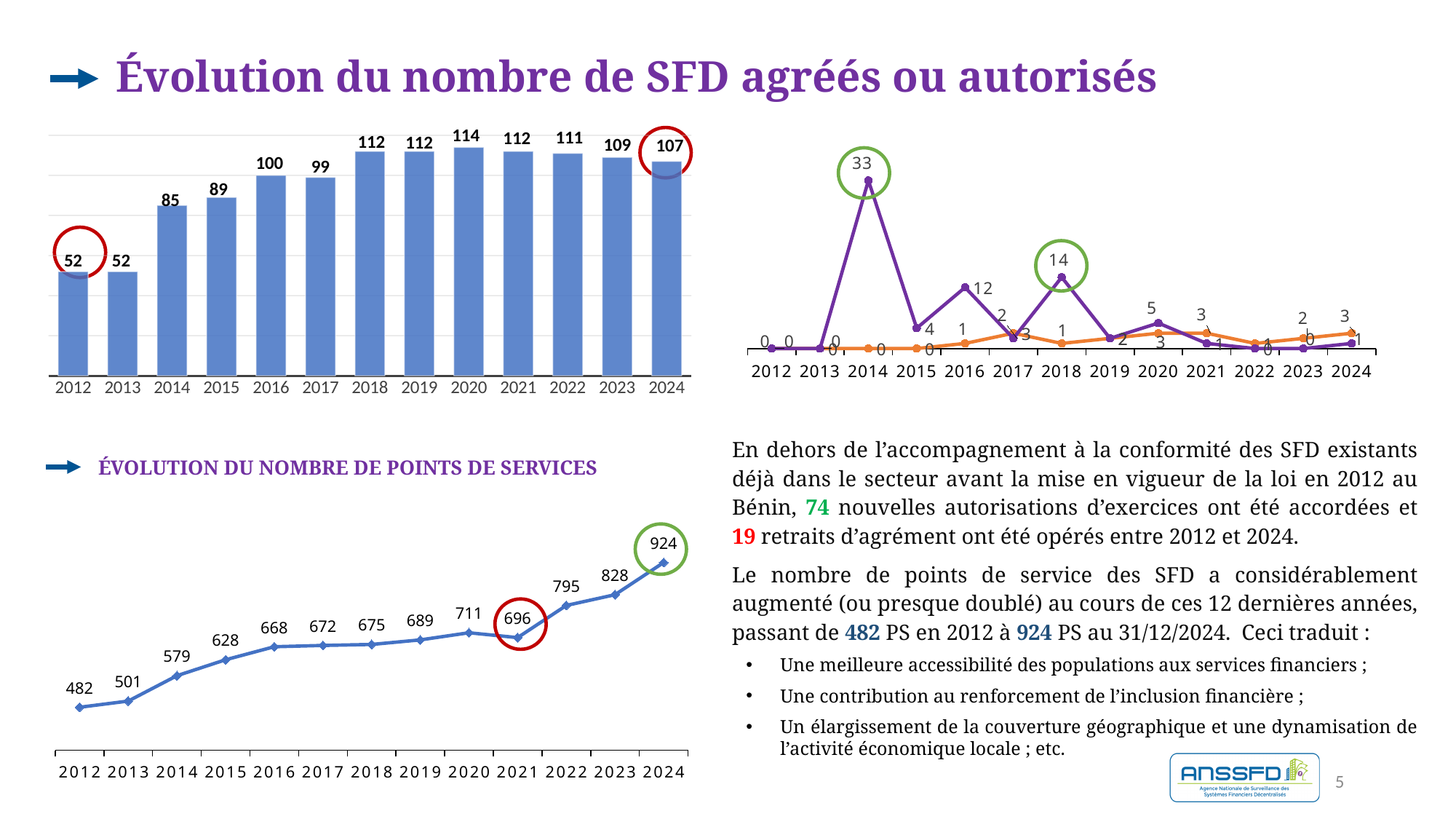
What kind of chart is the chart titled 'ÉVOLUTION DU NOMBRE DE POINTS DE SERVICES'? line chart In the top-left bar chart, what is the value for 2020? 114 In the top-left bar chart, what is the lowest value shown? 52 How many years are shown in the top-left bar chart? 13 In the top-left bar chart, what is the difference between the values for 2024 and 2012? 55 In the top-right line chart, what is the highest value of the purple line and in which year does it occur? 33 in 2014 In the top-left bar chart, which year has the larger value, 2016 or 2017? 2016 In the chart titled 'ÉVOLUTION DU NOMBRE DE POINTS DE SERVICES', what is the value for 2021? 696 In the chart titled 'ÉVOLUTION DU NOMBRE DE POINTS DE SERVICES', what is the difference between the values for 2022 and 2021? 99 What kind of chart is the top-left chart on the slide? bar chart In the top-left bar chart, which year has the highest value? 2020 In the chart titled 'ÉVOLUTION DU NOMBRE DE POINTS DE SERVICES', what is the value for 2024? 924